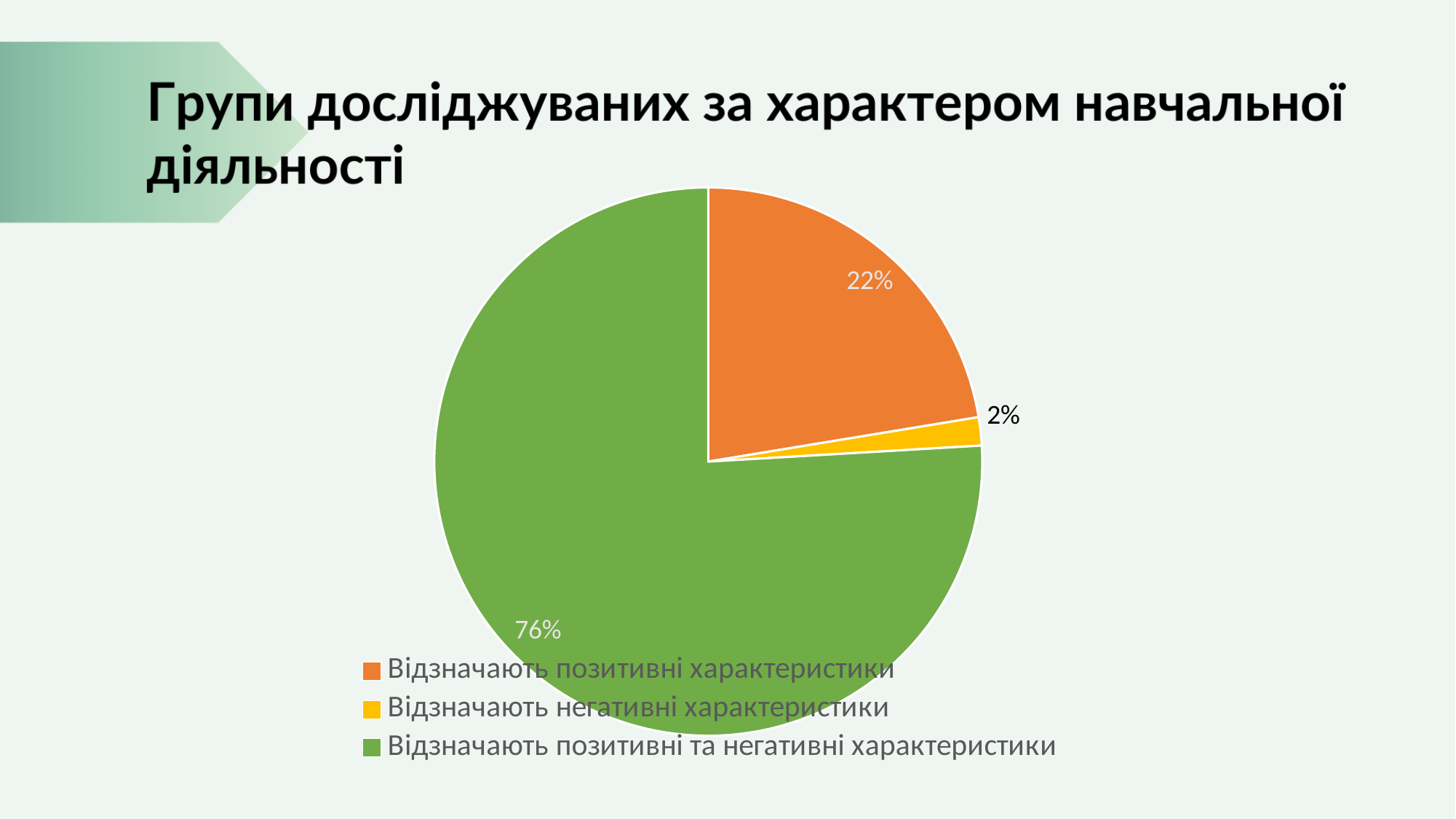
What is the difference in percentage points between the "Відзначають позитивні та негативні характеристики" slice and the "Відзначають позитивні характеристики" slice? 54 What share of the pie is labelled "Відзначають негативні характеристики"? 2% Which category has the largest slice of the pie? Відзначають позитивні та негативні характеристики Which is larger: the slice for "Відзначають позитивні характеристики" or the slice for "Відзначають негативні характеристики"? Відзначають позитивні характеристики What kind of chart is shown on the slide? pie chart What colour is the slice for "Відзначають негативні характеристики"? yellow What is the title of the slide containing the chart? Групи досліджуваних за характером навчальної діяльності Which category has the smallest slice of the pie? Відзначають негативні характеристики How many slices does the pie chart have? 3 How many entries does the legend list? 3 What share of the pie is labelled "Відзначають позитивні характеристики"? 22% What share of the pie is labelled "Відзначають позитивні та негативні характеристики"? 76%